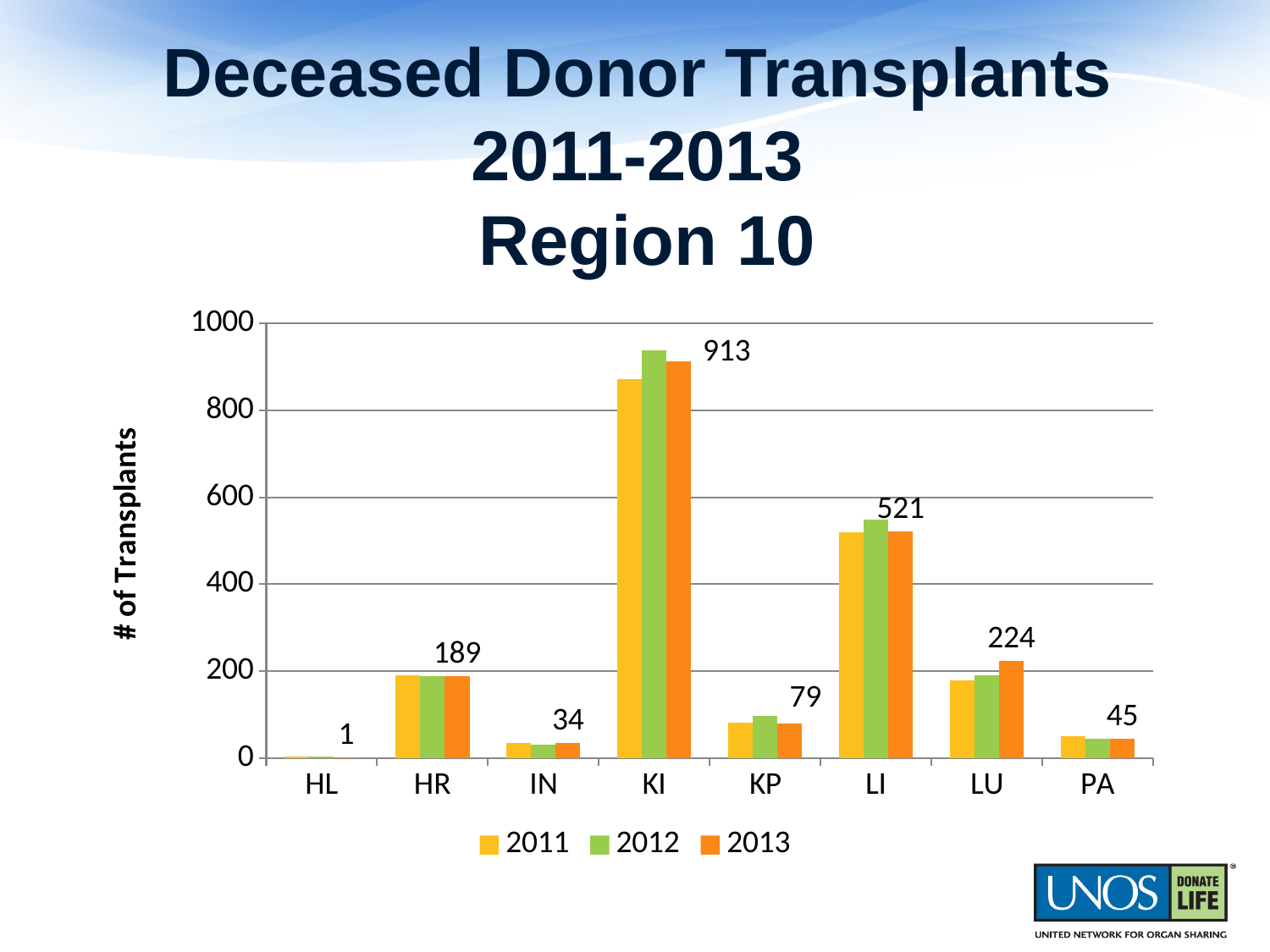
How many organ categories are shown on the x axis? 8 What is the 2013 value for KI? 913 Which category has the highest 2013 value? KI Which category has the lowest 2013 value? HL How many series does the legend list? 3 What type of chart is shown on the slide? bar chart What is the 2013 value for PA? 45 What is the 2013 value for LU? 224 Is the 2012 value for KI greater or less than 900? greater What is the label on the y axis? # of Transplants What is the difference between the 2013 values for KI and LI? 392 Which is larger, the 2013 value for HR or the 2013 value for LU? LU